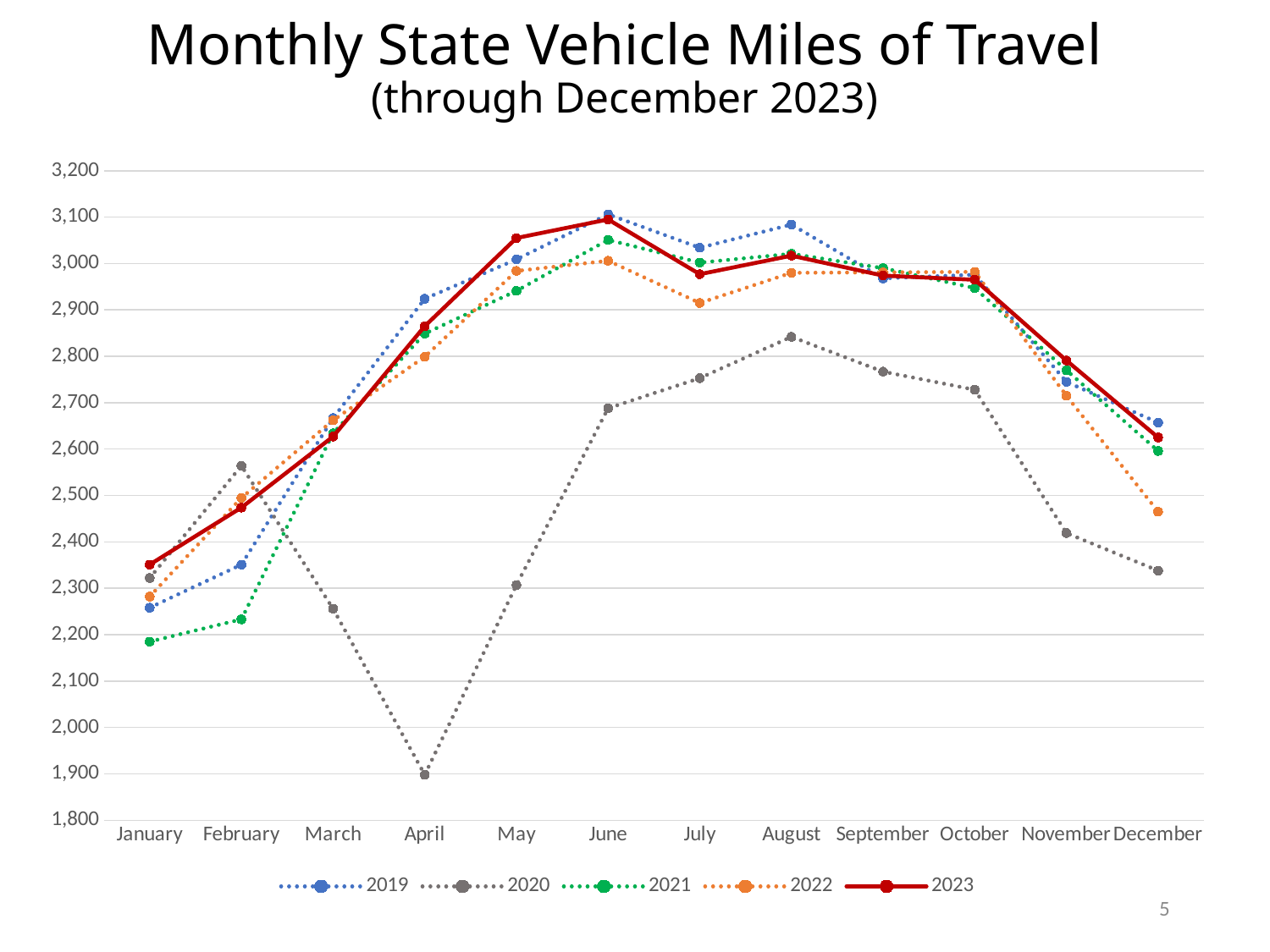
How many months are plotted along the x axis? 12 Is the value for 2023 in June greater or less than 3,000? greater Is the value for 2020 in April greater or less than 2,000? less In which month does the 2020 series reach its highest value? August What kind of chart is shown on the slide? line chart In April, which series has the larger value, 2020 or 2023? 2023 In which month does the 2023 series reach its lowest value? January Does the 2020 series rise or fall from January to April? fall Is the value for 2022 in December greater or less than 2,500? less How many series does the legend list? 5 Which series is drawn as a solid line rather than a dotted line? 2023 In which month does the 2020 series reach its lowest value? April